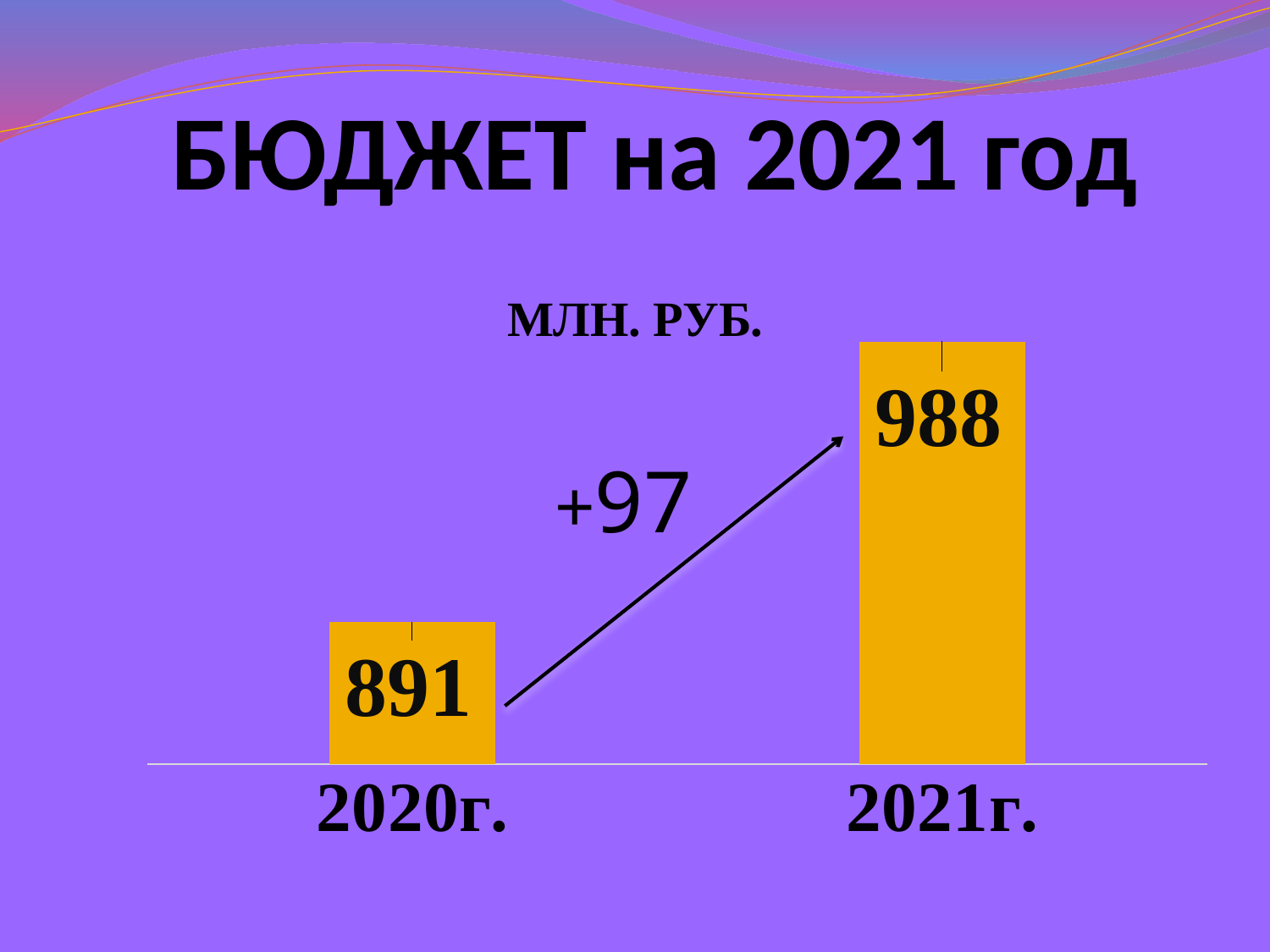
What change is written next to the arrow between the two bars? +97 Which year has the higher value? 2021г. What is the difference between the values for 2021г. and 2020г.? 97 Which year has the lower value? 2020г. What kind of chart is shown on the slide? bar chart What is the value for 2020г.? 891 What unit is shown above the chart? МЛН. РУБ. What is the title of the slide? БЮДЖЕТ на 2021 год Do the values rise or fall from 2020г. to 2021г.? rise Is the value for 2021г. larger or smaller than the value for 2020г.? larger How many bars are shown in the chart? 2 What is the value for 2021г.? 988